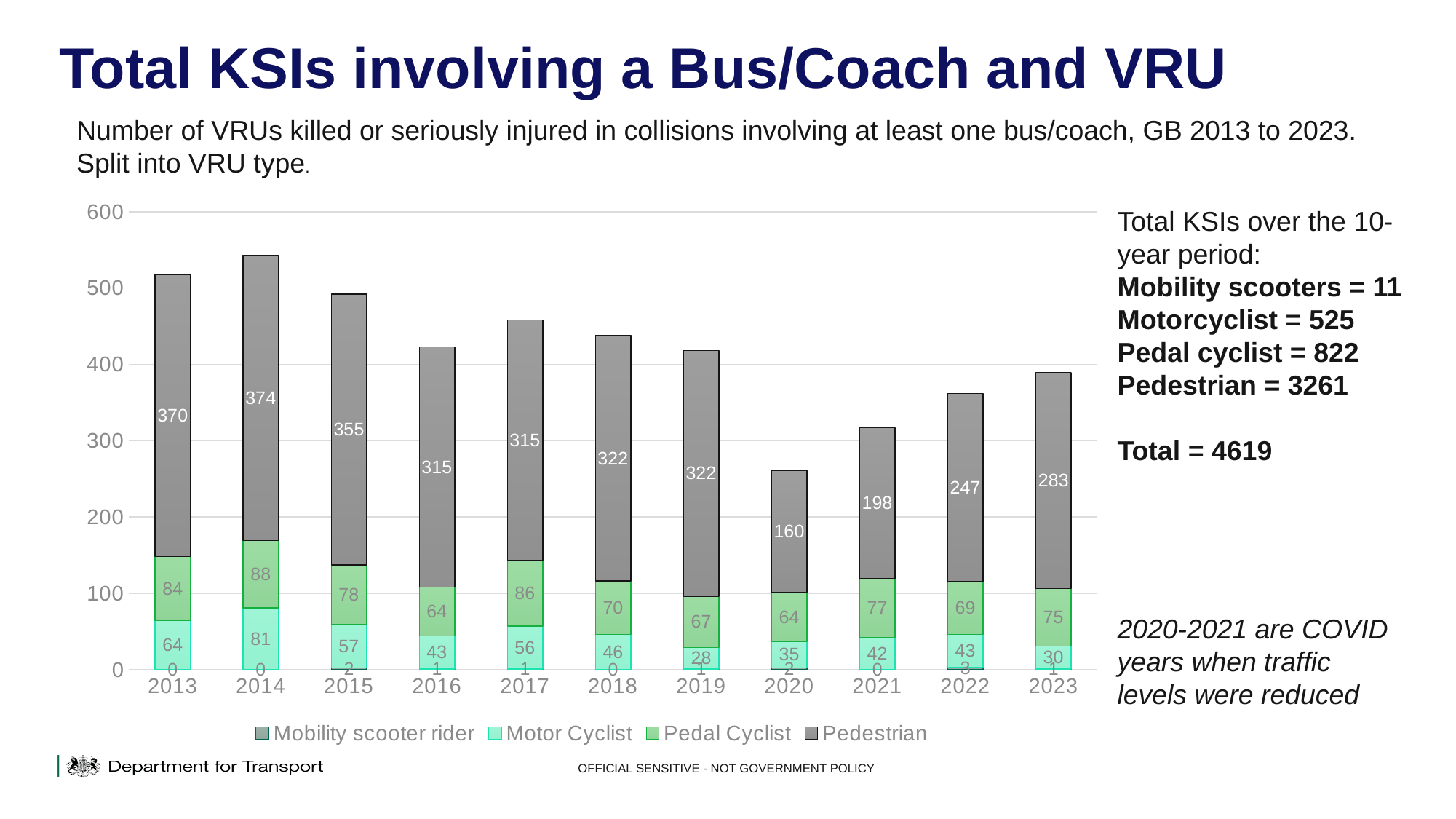
Which is larger, the Motor Cyclist value for 2014 or for 2019? 2014 What is the Pedal Cyclist value for 2017? 86 What kind of chart is shown on the slide? Stacked bar chart In which year is the Pedestrian value lowest? 2020 What is the total of the stacked bar for 2020? 261 What is the Motor Cyclist value for 2014? 81 Is the total height of the 2014 stacked bar greater or less than 500? greater How many years are shown on the x axis? 11 In which year is the Pedestrian value highest? 2014 What is the difference between the Pedestrian values for 2013 and 2023? 87 How many series does the legend list? 4 What is the Pedestrian value for 2020? 160